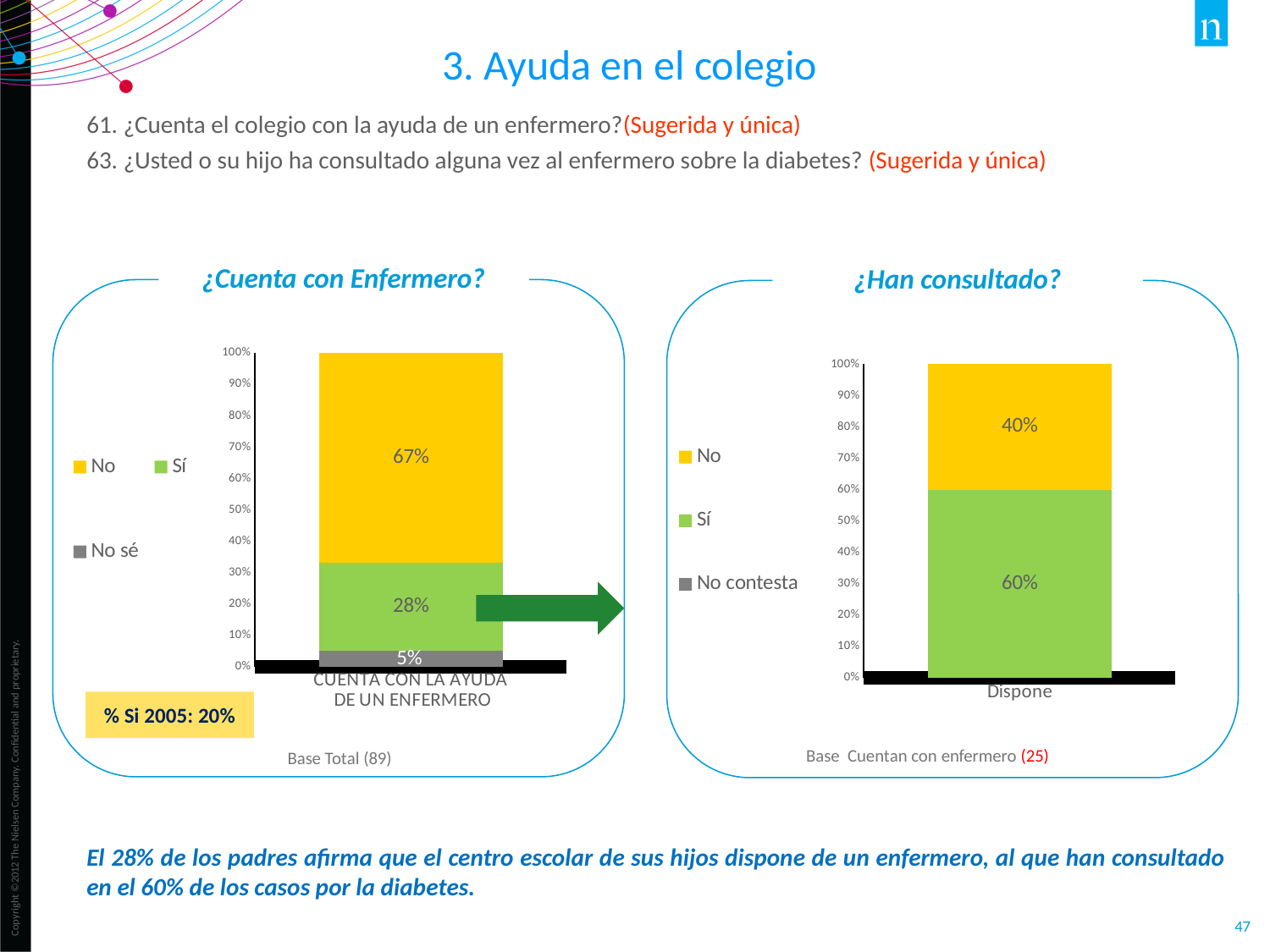
How many series does the legend of the '¿Han consultado?' chart list? 3 In the '¿Cuenta con Enfermero?' chart, which response has the largest share? No In the '¿Cuenta con Enfermero?' chart, what percentage is shown for 'No sé'? 5% In the '¿Cuenta con Enfermero?' chart, what percentage is shown for 'Sí'? 28% In the '¿Cuenta con Enfermero?' chart, which response has the smallest share? No sé In the '¿Han consultado?' chart, what is the difference between the 'Sí' and 'No' percentages? 20% What type of chart is the '¿Cuenta con Enfermero?' chart? Stacked bar chart In the '¿Cuenta con Enfermero?' chart, what is the difference between the 'No' and 'Sí' percentages? 39% In the '¿Han consultado?' chart, what percentage is shown for 'Sí'? 60% In the '¿Han consultado?' chart, which is larger, 'Sí' or 'No'? Sí In the '¿Cuenta con Enfermero?' chart, what percentage is shown for 'No'? 67% In the '¿Han consultado?' chart, what percentage is shown for 'No'? 40%